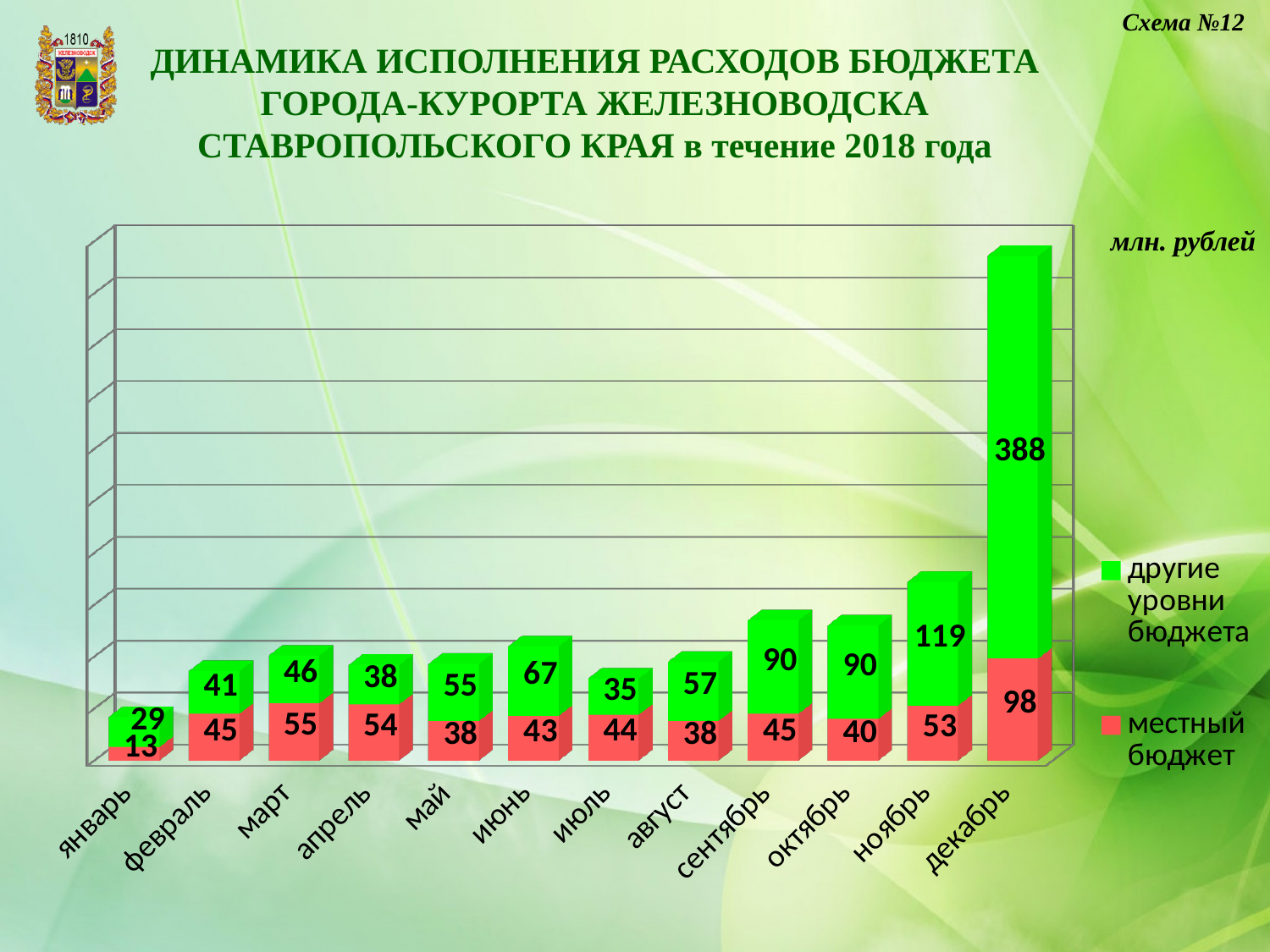
Which is larger: 'местный бюджет' for апрель or 'местный бюджет' for май? апрель What is the value of 'другие уровни бюджета' for декабрь? 388 Which month has the highest value for 'другие уровни бюджета'? декабрь What is the difference between 'другие уровни бюджета' for декабрь and for ноябрь? 269 What is the total of the stacked bar for ноябрь? 172 What is the value of 'местный бюджет' for январь? 13 What type of chart is shown on the slide? bar chart How many series does the legend list? 2 How many months (categories) are shown on the x axis? 12 Which month has the lowest value for 'местный бюджет'? январь What is the value of 'местный бюджет' for март? 55 What unit is stated for the values on the chart? млн. рублей